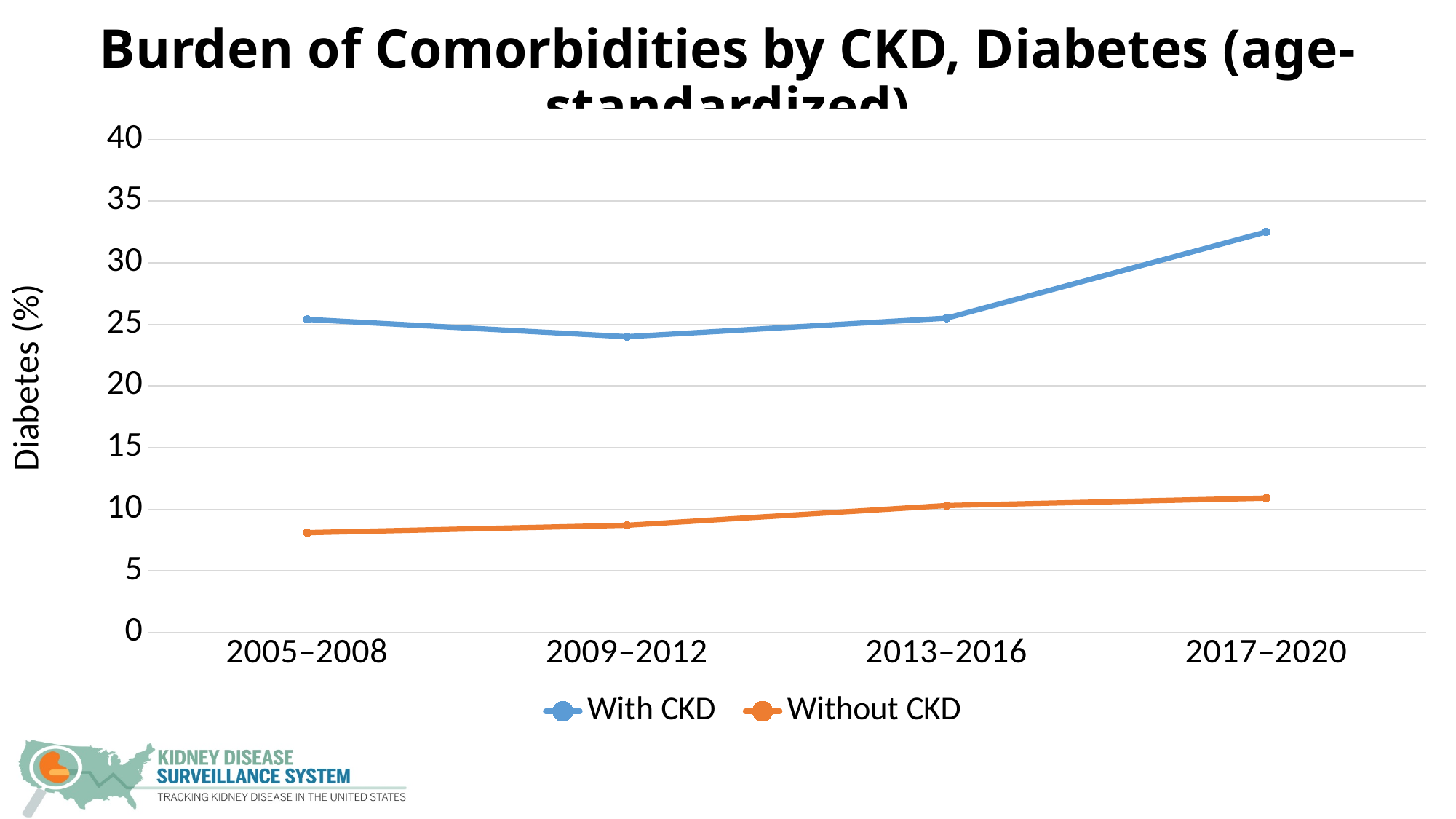
In 2017–2020, which series has the larger value, With CKD or Without CKD? With CKD How many time periods are plotted along the x axis? 4 In which period is the Without CKD value lowest? 2005–2008 Is the Without CKD value for 2005–2008 greater or less than 10? less Is the With CKD value for 2017–2020 greater or less than 30? greater In which period is the With CKD value lowest? 2009–2012 What kind of chart is shown on the slide? line chart Is the With CKD value for 2009–2012 greater or less than 25? less In which period is the With CKD value highest? 2017–2020 How many series does the legend list? 2 What is the label on the y axis? Diabetes (%) Does the Without CKD line rise or fall from 2005–2008 to 2017–2020? rise